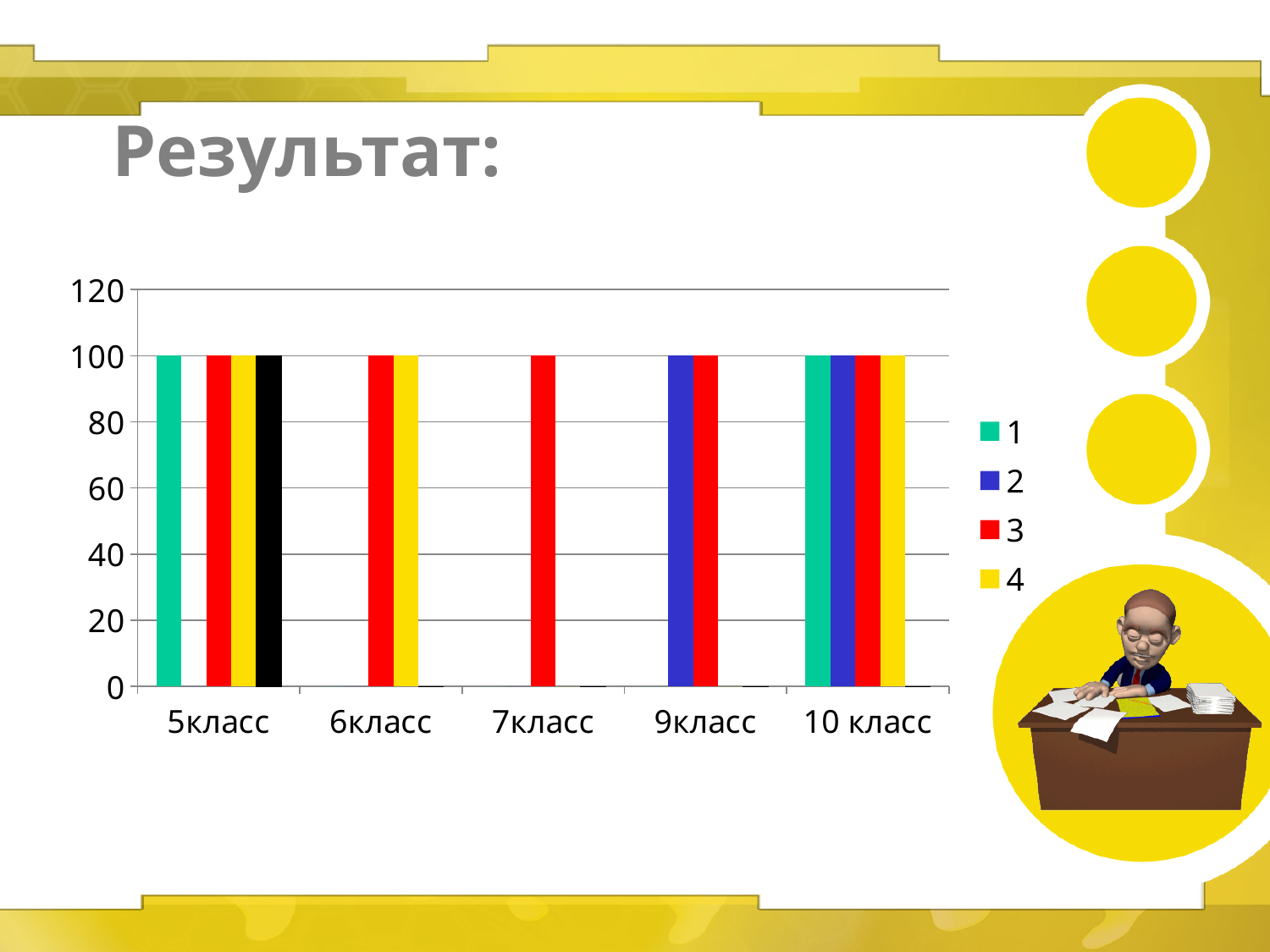
Is the value of series 3 for 6класс greater or less than 80? greater What is the value of series 1 for 5класс? 100 How many categories are shown on the x axis of the chart? 5 What is the highest value shown on the vertical axis? 120 What is the value of series 3 for 7класс? 100 What is the value of series 2 for 9класс? 100 What is the value of series 4 for 10 класс? 100 Which category has the most bars plotted? 5класс and 10 класс What kind of chart is shown on the slide? bar chart How many series does the chart legend list? 4 Which category has only one bar plotted? 7класс What is the title of the slide? Результат: